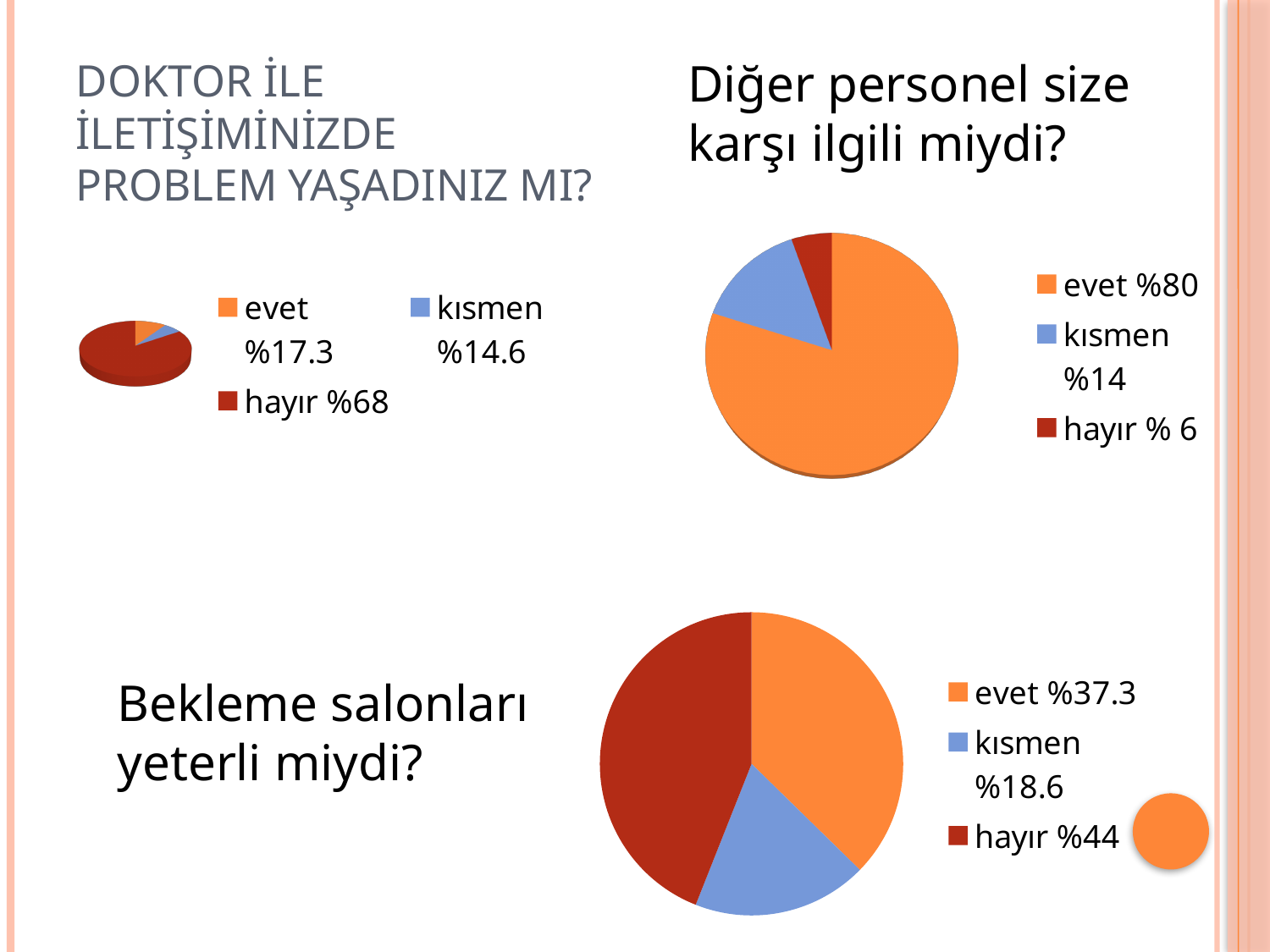
What kind of chart is used for 'Bekleme salonları yeterli miydi?'? pie chart In the chart titled 'Bekleme salonları yeterli miydi?', what percentage is shown for 'kısmen'? %18.6 In the chart titled 'Bekleme salonları yeterli miydi?', what is the difference in percentage points between 'hayır' and 'evet'? 6.7 How many categories does the legend of the chart titled 'Diğer personel size karşı ilgili miydi?' list? 3 In the chart titled 'DOKTOR İLE İLETİŞİMİNİZDE PROBLEM YAŞADINIZ MI?', what percentage is shown for 'evet'? %17.3 In the chart titled 'DOKTOR İLE İLETİŞİMİNİZDE PROBLEM YAŞADINIZ MI?', which category has the largest share? hayır In the chart titled 'Diğer personel size karşı ilgili miydi?', which category has the smallest share? hayır In the chart titled 'Diğer personel size karşı ilgili miydi?', what is the difference in percentage points between 'evet' and 'kısmen'? 66 In the chart titled 'Bekleme salonları yeterli miydi?', which is larger, 'evet' or 'hayır'? hayır In the chart titled 'Diğer personel size karşı ilgili miydi?', what percentage is shown for 'kısmen'? %14 In the chart titled 'Bekleme salonları yeterli miydi?', what percentage is shown for 'hayır'? %44 In the chart titled 'DOKTOR İLE İLETİŞİMİNİZDE PROBLEM YAŞADINIZ MI?', what percentage is shown for 'hayır'? %68